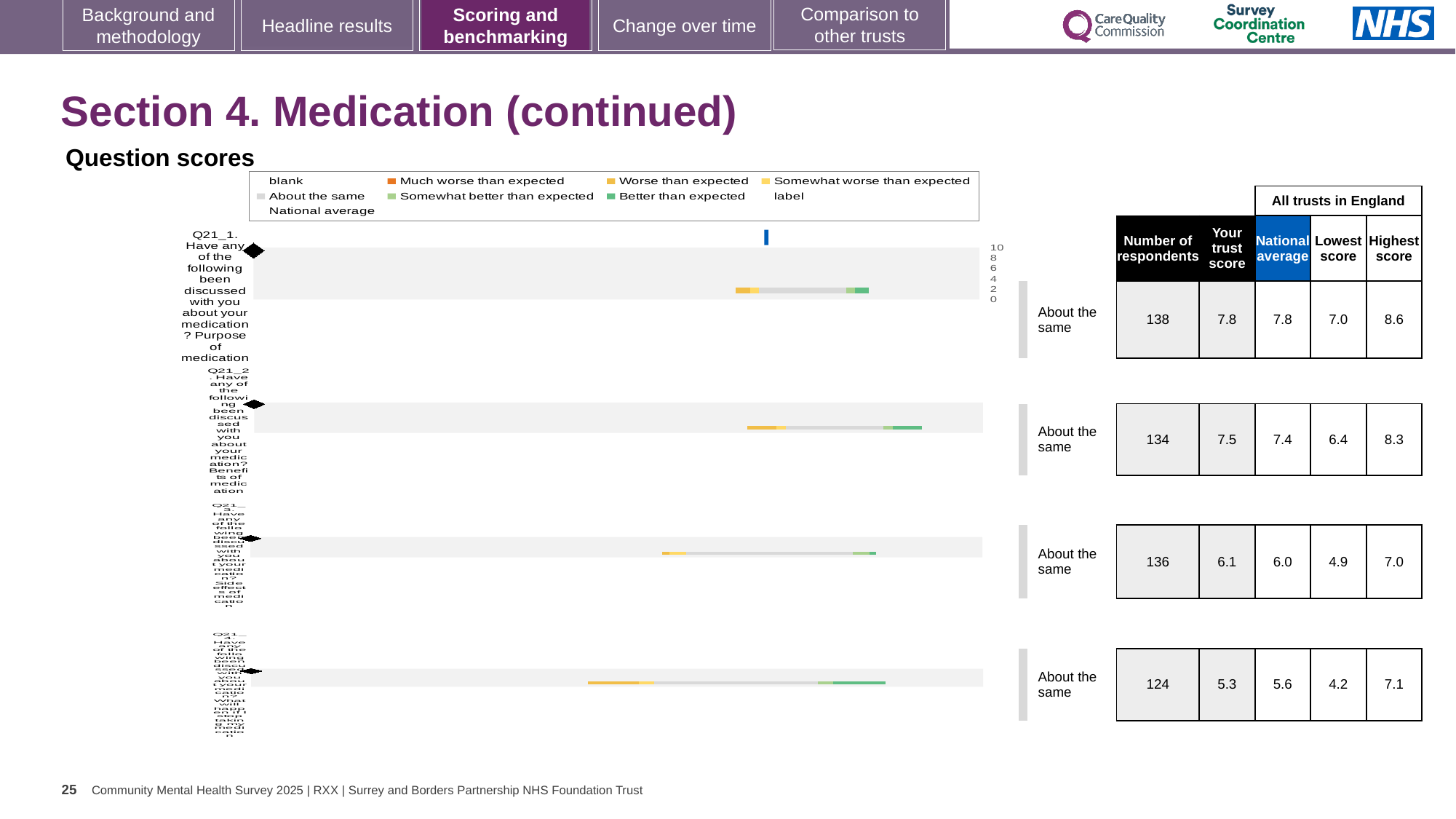
For Q21_3, is the trust score or the national average larger? trust score (6.1) What kind of chart is used to show the question scores on this slide? bar chart For Q21_4, what is the difference between the highest score and the lowest score across all trusts in England? 2.9 In the chart legend, which colour represents 'Much worse than expected'? orange How many questions (bars) are plotted in the question scores chart? 4 What is the highest score across all trusts in England for Q21_3 (Side effects of medication)? 7.0 What is the trust score for Q21_2 (Benefits of medication)? 7.5 What is the national average for Q21_4 (What will happen if I stop taking medication)? 5.6 Which question has the highest trust score? Q21_1 (Purpose of medication) How many respondents are listed for Q21_1 (Purpose of medication)? 138 What is the highest value shown on the score axis of the chart? 10 Which question has the lowest trust score? Q21_4 (What will happen if I stop taking medication)